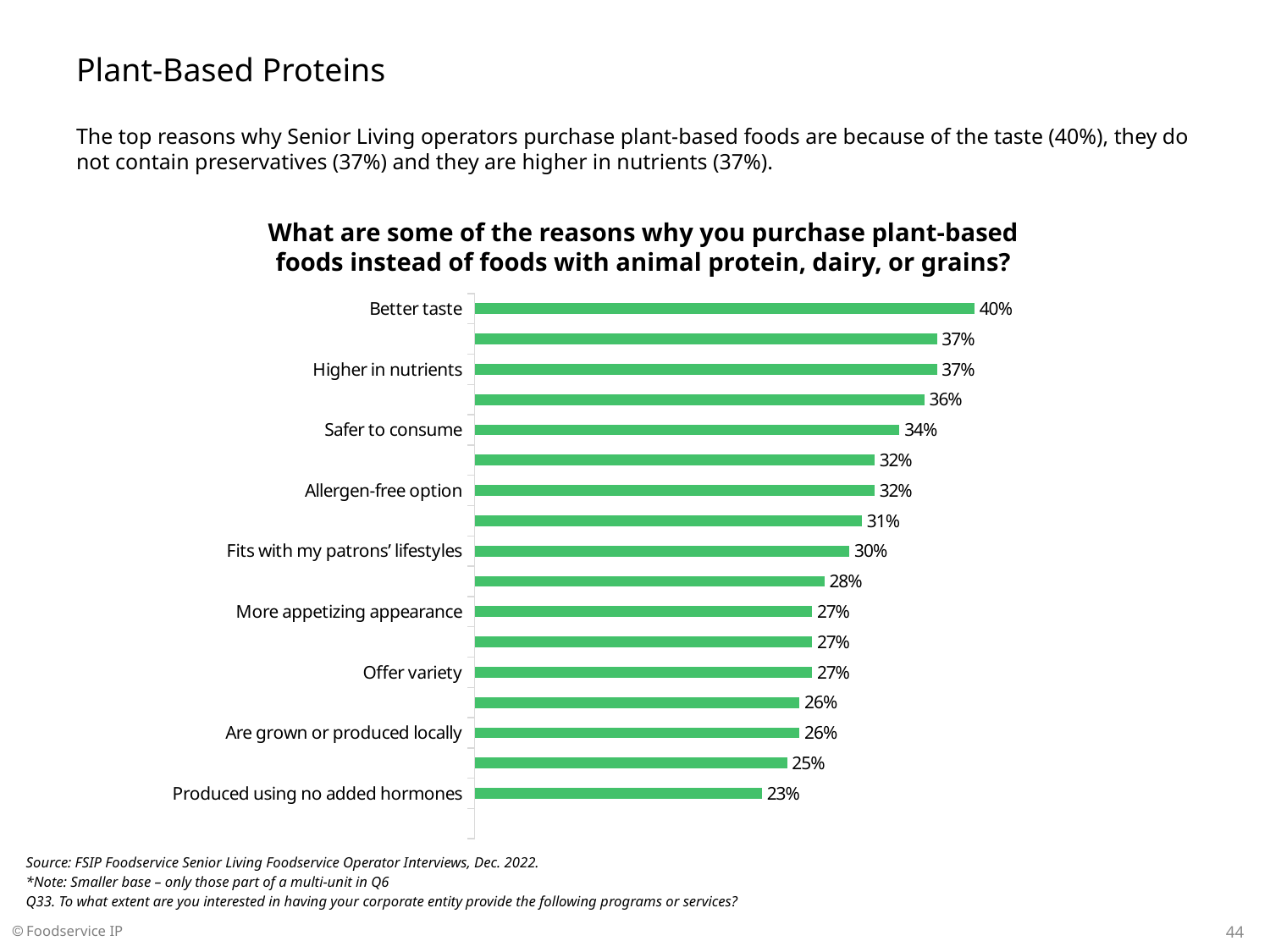
Which reason has the lowest percentage in the chart? Produced using no added hormones Which reason has the highest percentage in the chart? Better taste What is the difference in percentage points between "Better taste" and "Produced using no added hormones"? 17 percentage points What is the value shown for "Higher in nutrients"? 37% What type of chart is used on this slide? Bar chart What percentage is shown for "Produced using no added hormones"? 23% What is the value for "Are grown or produced locally"? 26% Which has a higher value, "Safer to consume" or "Allergen-free option"? Safer to consume Do the bar values increase or decrease from the top of the chart to the bottom? Decrease What percentage of respondents cited "Better taste" as a reason for purchasing plant-based foods? 40% How many bars are plotted in the chart? 17 What is the value shown for "Safer to consume"? 34%